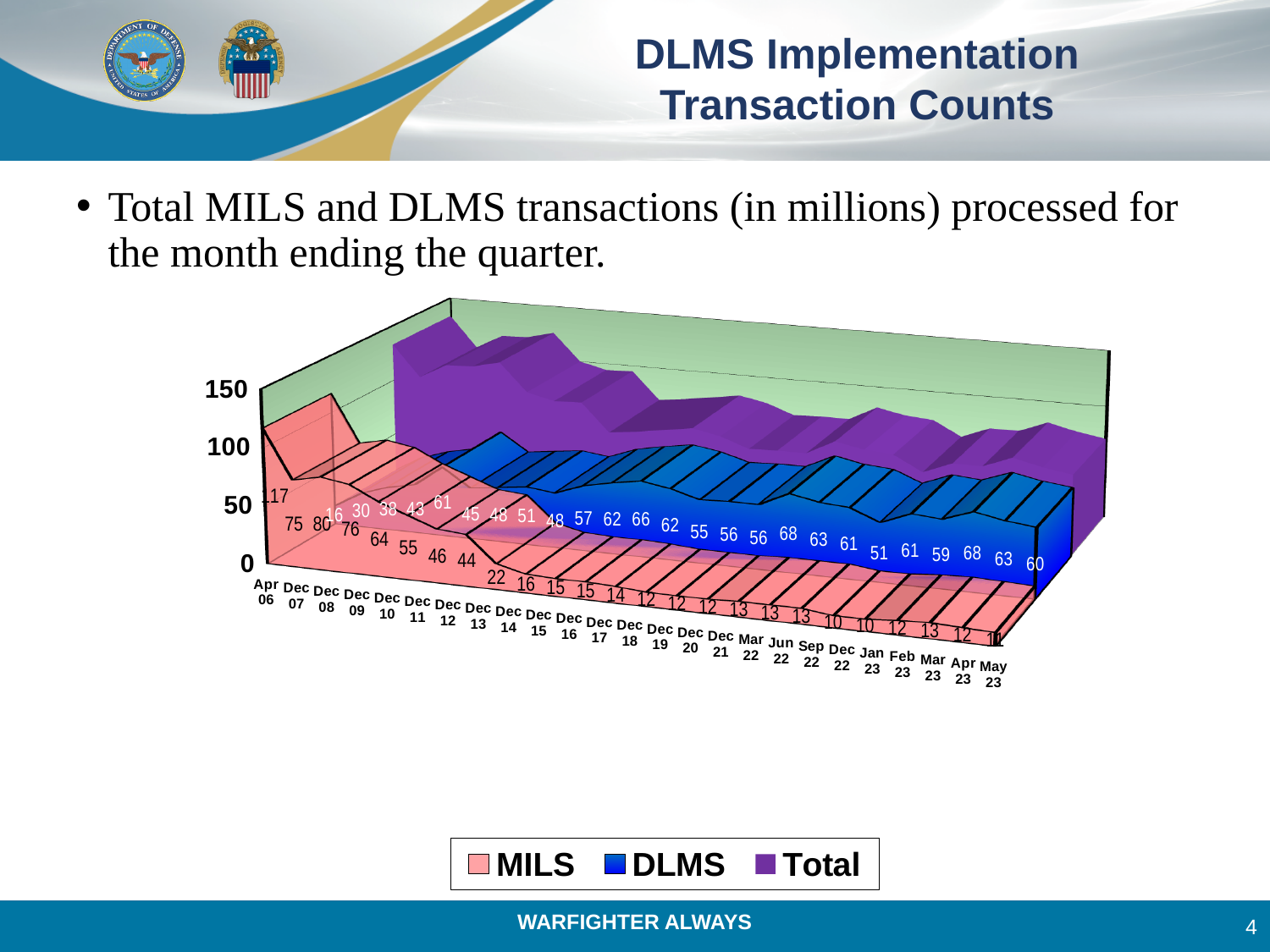
What is the highest DLMS value labelled on the chart? 68 Which period has the highest MILS value? Apr 06 Which series are listed in the legend? MILS, DLMS, Total Do the MILS values generally rise or fall from Apr 06 to May 23? fall Which is larger, the MILS value for Dec 08 or for Dec 09? Dec 08 What is the lowest MILS value labelled on the chart? 10 What is the difference between the MILS values for Apr 06 and Dec 07? 42 How many series does the legend list? 3 What is the MILS value for Apr 06? 117 What kind of chart is shown on the slide? area chart What is the MILS value for Dec 07? 75 How many time periods are shown along the x axis? 25